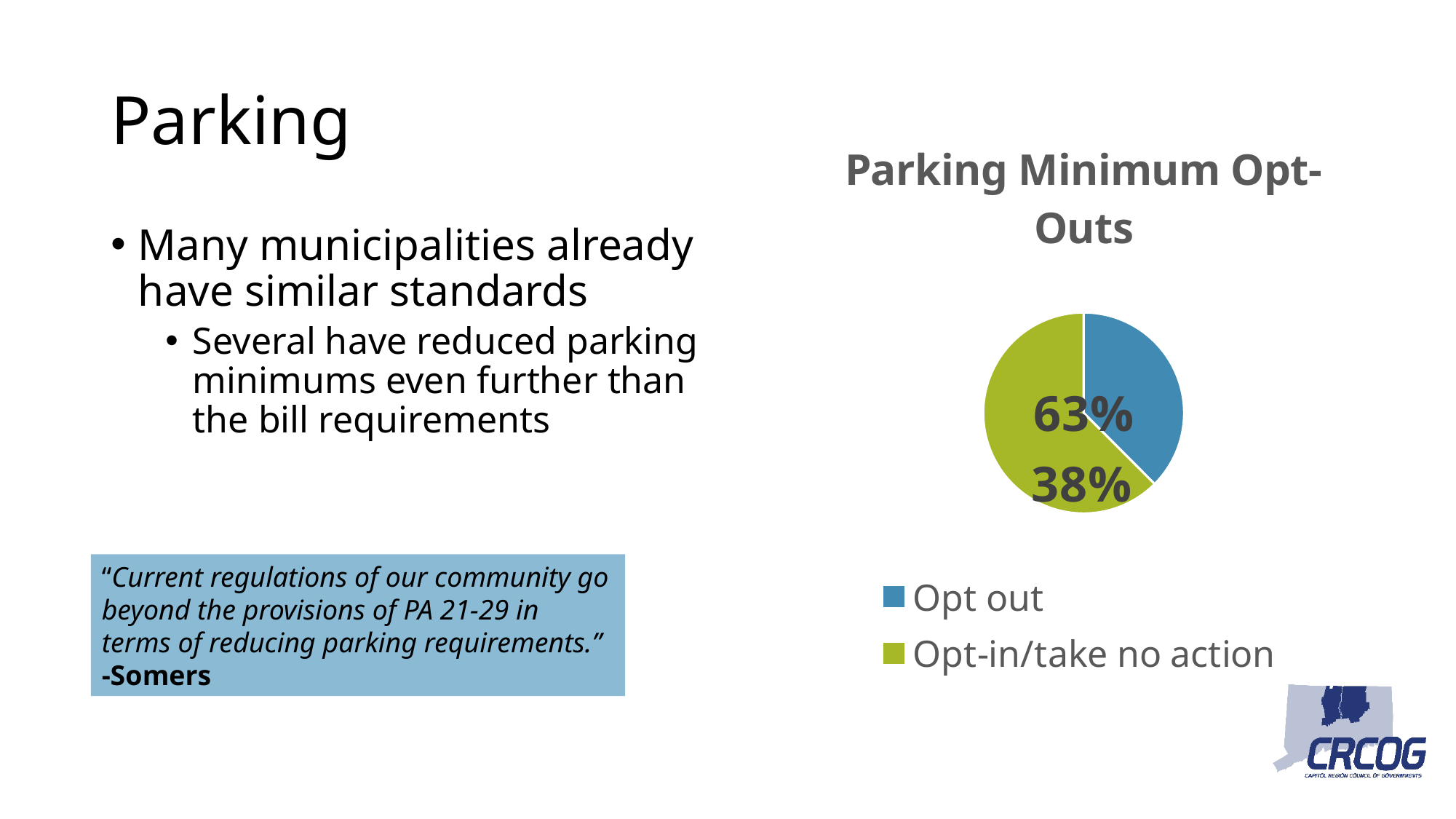
What colour is the Opt out slice in the pie chart? blue How many entries does the chart's legend list? 2 What share of the pie is labelled for Opt-in/take no action? 63% What share of the pie is labelled for Opt out? 38% What kind of chart is shown on the slide? pie chart Which is larger in the pie chart, Opt out or Opt-in/take no action? Opt-in/take no action How many slices does the pie chart have? 2 Which slice of the pie chart is the largest? Opt-in/take no action Which slice of the pie chart is the smallest? Opt out Is the share for Opt out greater or less than 50%? less What is the difference in percentage points between the two slices of the pie chart? 25 What is the title of the chart on the slide? Parking Minimum Opt-Outs